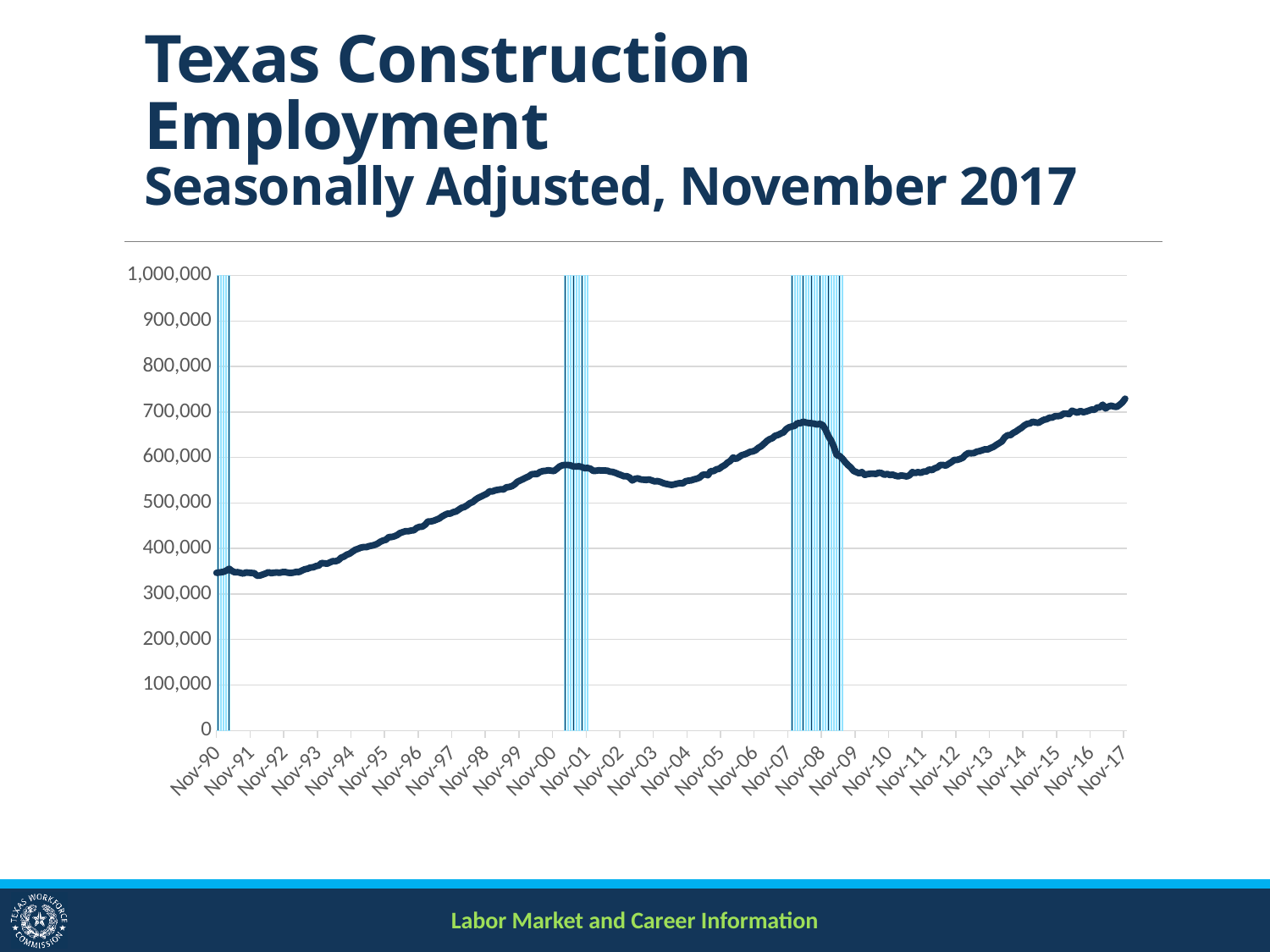
Is the value for Nov-14 greater or less than 600,000? greater Is the value for Nov-04 greater or less than 500,000? greater Overall, do the values rise or fall from Nov-90 to Nov-17? rise How many x-axis labels (Nov-90 through Nov-17) are shown on the chart? 28 Is the value for Nov-17 greater or less than 700,000? greater What is the title of the chart on the slide? Texas Construction Employment, Seasonally Adjusted, November 2017 Do the values rise or fall between Nov-08 and Nov-10? fall Which is larger, the value for Nov-08 or the value for Nov-10? Nov-08 What kind of chart is shown on the slide? line chart